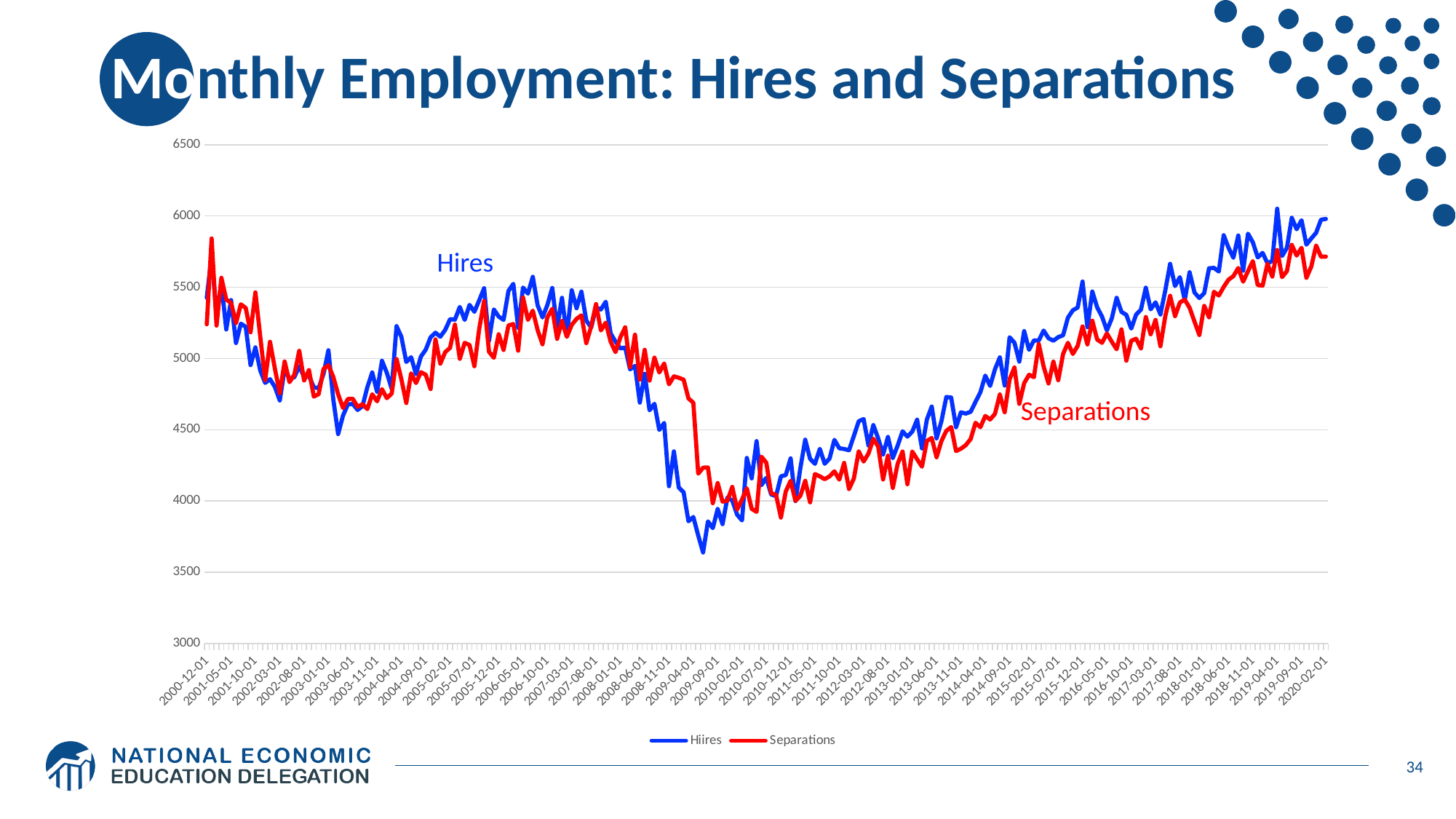
What kind of chart is shown on the slide? line chart Is the value for Separations at 2020-02-01 greater or less than 5500? greater Which series is higher at 2009-04-01, Hires or Separations? Separations Do Separations rise or fall between 2011-05-01 and 2019-04-01? rise How many series does the legend list? 2 Is the value for Separations at 2010-02-01 greater or less than 4500? less What are the two series shown in the chart? Hires and Separations Which series reaches the highest value anywhere on the chart? Hires Is the value for Hires at 2003-06-01 greater or less than 5000? less What colour is the Hires line? blue Do Hires rise or fall between 2008-06-01 and 2009-04-01? fall